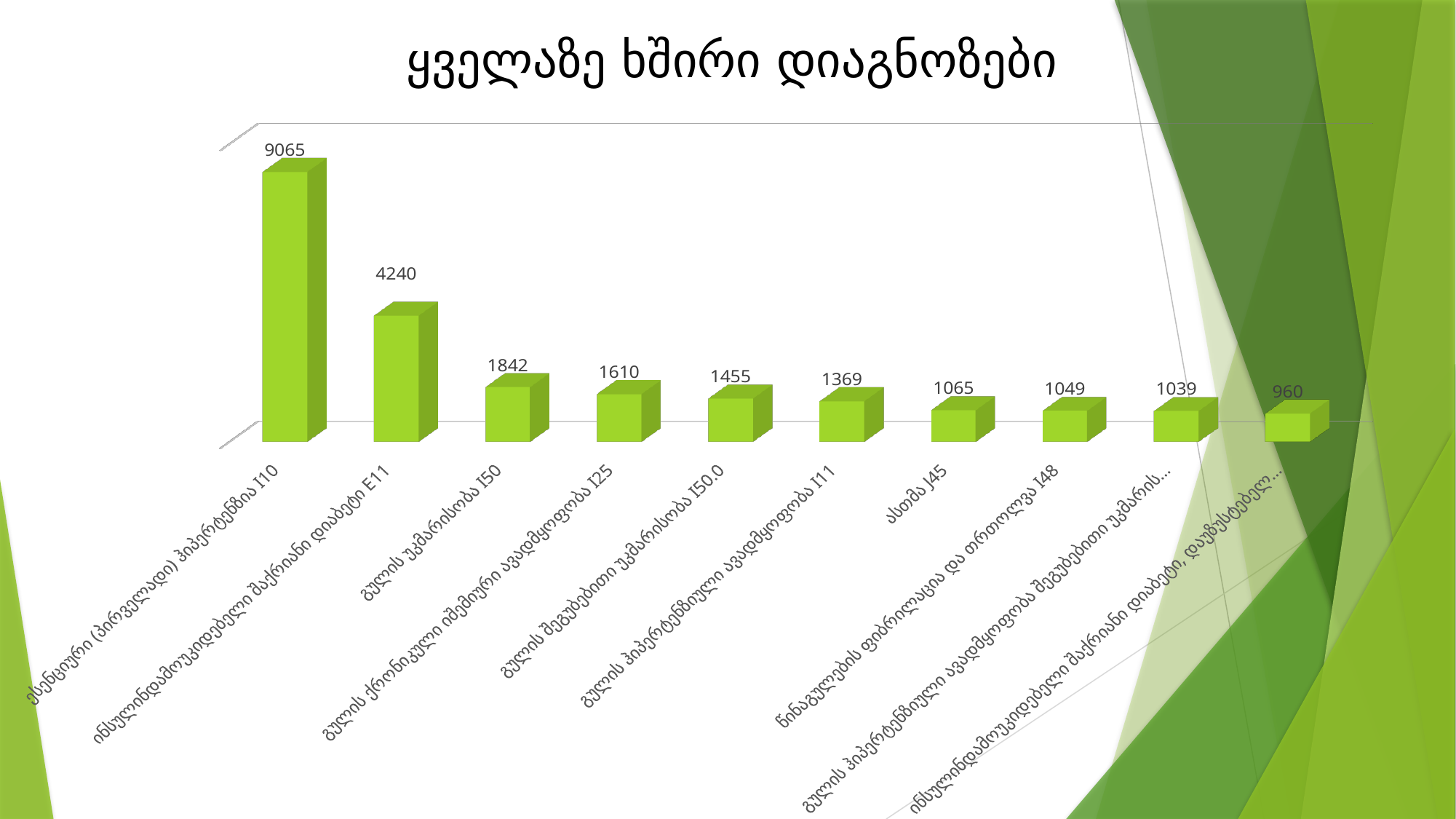
Which is larger, the value for გულის ქრონიკული იშემიური ავადმყოფობა I25 or for გულის ჰიპერტენზიული ავადმყოფობა I11? გულის ქრონიკული იშემიური ავადმყოფობა I25 What is the value for ესენციური (პირველადი) ჰიპერტენზია I10? 9065 Which category has the highest value? ესენციური (პირველადი) ჰიპერტენზია I10 What is the value for ინსულინდამოუკიდებელი შაქრიანი დიაბეტი E11? 4240 What is the title of the chart? ყველაზე ხშირი დიაგნოზები What is the difference between the values for I10 and E11? 4825 How many bars are shown in the chart? 10 What is the value for წინაგულების ფიბრილაცია და თრთოლვა I48? 1049 What is the value for ასთმა J45? 1065 What kind of chart is shown on the slide? bar chart What is the difference between the values for გულის უკმარისობა I50 and გულის შეგუბებითი უკმარისობა I50.0? 387 What is the value of the lowest bar (the rightmost one)? 960